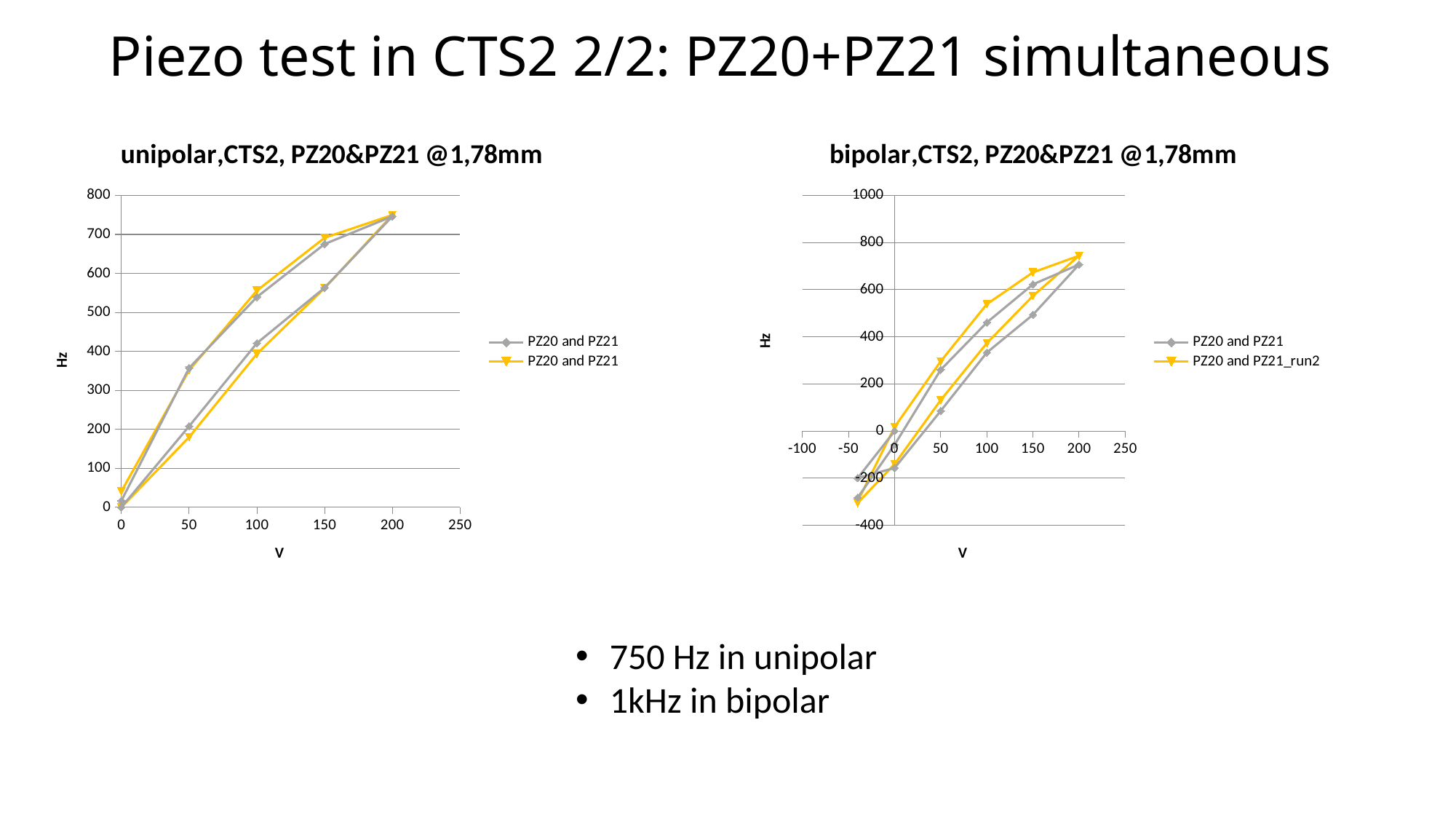
How many series does the legend of the left (unipolar) chart list? 2 In the right (bipolar) chart, is the lowest value plotted at 0 V greater or less than 0? less How many series does the legend of the right (bipolar) chart list? 2 In the left (unipolar) chart, is the value at 200 V greater or less than 700? greater What is the title of the chart on the left? unipolar,CTS2, PZ20&PZ21 @1,78mm In the left (unipolar) chart, is the highest value plotted at 150 V greater or less than 600? greater In the left (unipolar) chart, do the values rise or fall as the voltage increases from 0 to 200 V? rise What is the label of the vertical axis on the right (bipolar) chart? Hz What kind of chart is the unipolar,CTS2, PZ20&PZ21 @1,78mm chart on the left? line chart What kind of chart is the bipolar,CTS2, PZ20&PZ21 @1,78mm chart on the right? line chart